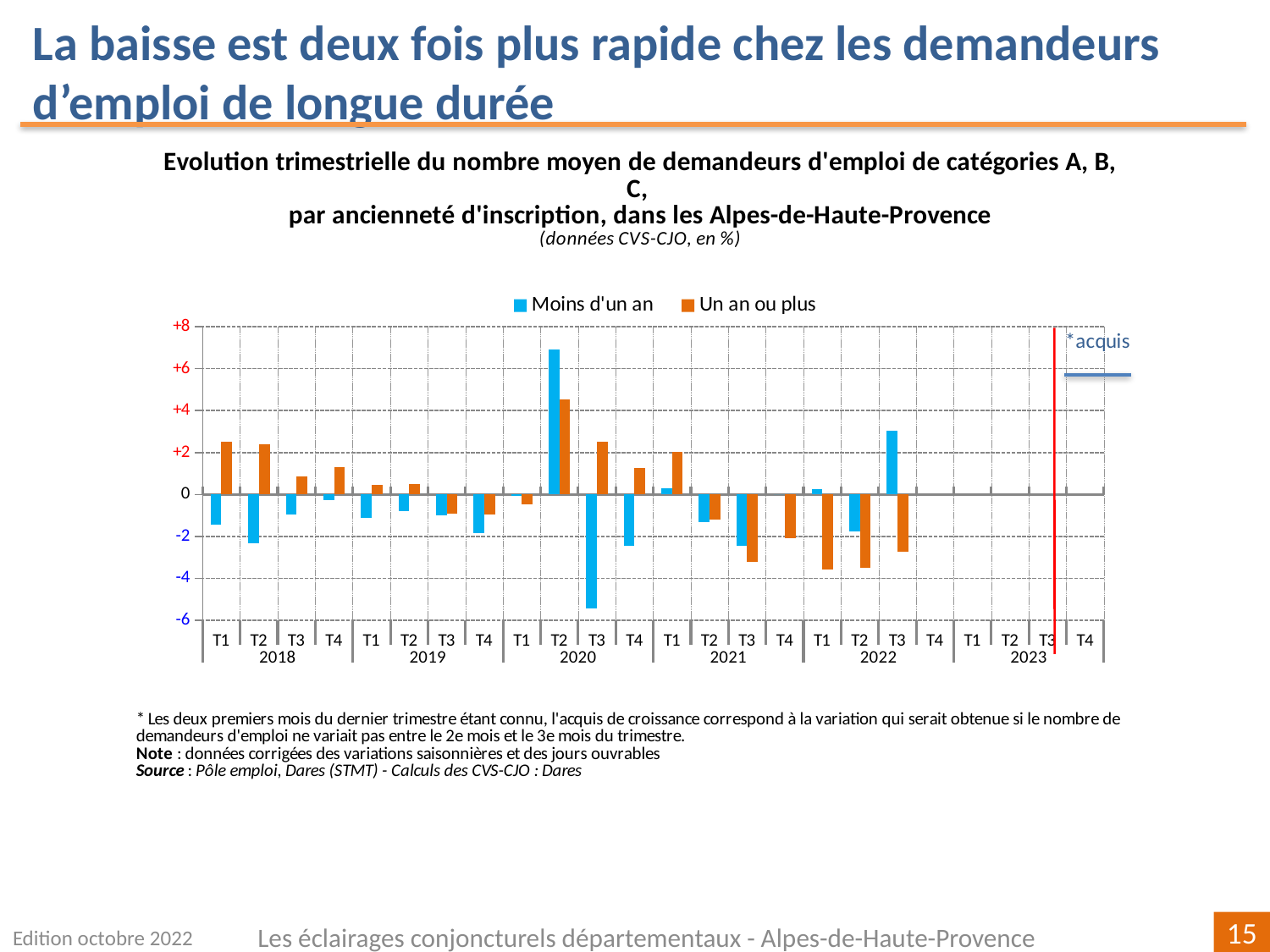
Is the value for 'Un an ou plus' in T1 2022 greater or less than -2? less Is the value for 'Moins d'un an' in T3 2020 greater or less than -4? less What kind of chart is shown on the slide? Bar chart In which quarter does the 'Moins d'un an' series reach its lowest value? T3 2020 Is the value for 'Moins d'un an' in T2 2020 greater or less than +6? greater How many series does the legend list? 2 In which quarter does the 'Moins d'un an' series reach its highest value? T2 2020 In T3 2022, which series has the larger value, 'Moins d'un an' or 'Un an ou plus'? Moins d'un an Which series is shown in orange in the legend? Un an ou plus In T1 2018, which series has the larger value, 'Moins d'un an' or 'Un an ou plus'? Un an ou plus In which quarter does the 'Un an ou plus' series reach its highest value? T2 2020